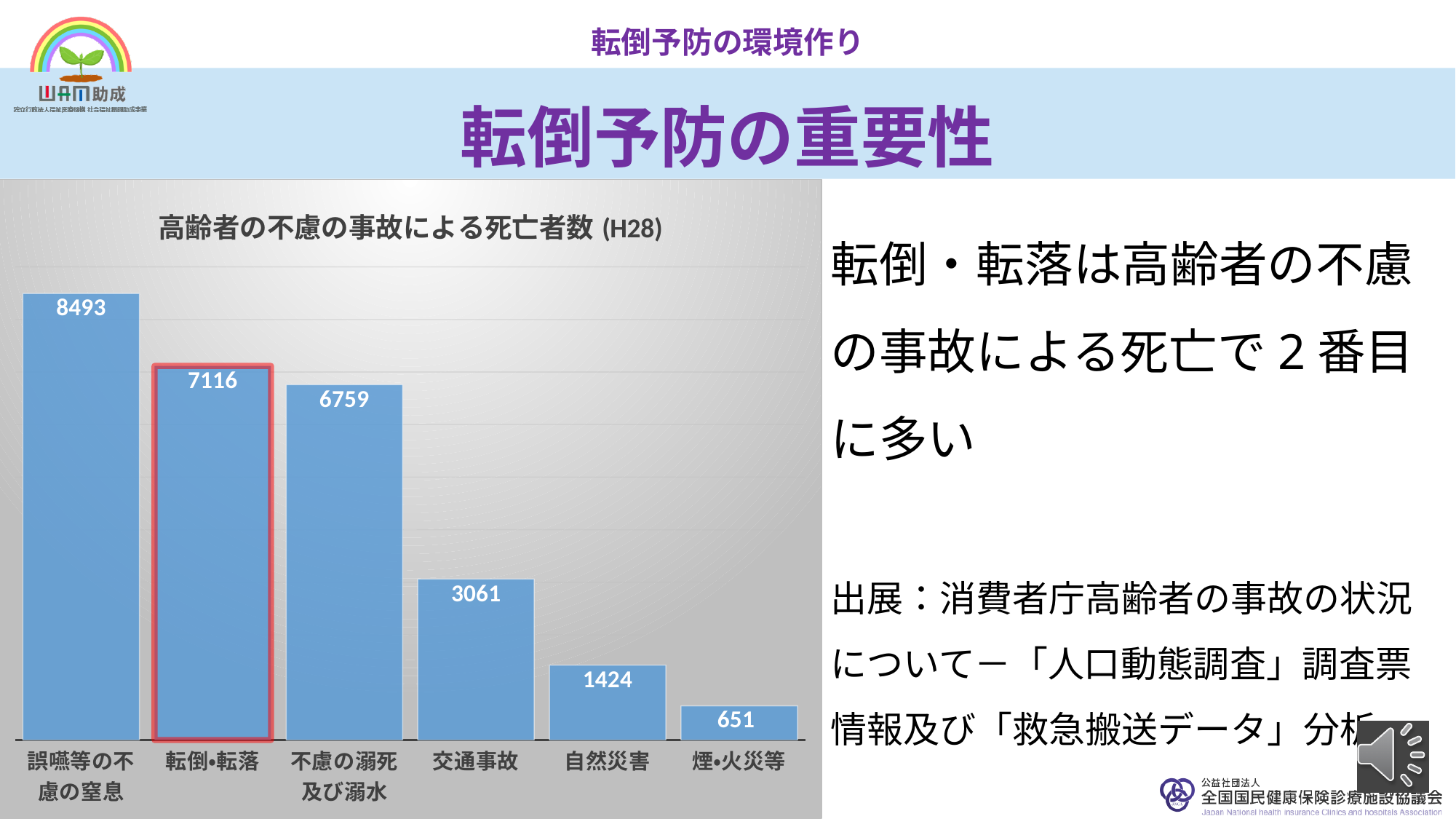
How many categories are shown in the chart? 6 What is the difference between 誤嚥等の不慮の窒息 and 転倒・転落? 1377 Which is larger, 自然災害 or 交通事故? 交通事故 What is the title of the chart? 高齢者の不慮の事故による死亡者数 (H28) Which category has the lowest value? 煙・火災等 What is the value for 転倒・転落? 7116 What is the value for 煙・火災等? 651 What kind of chart is shown? Bar chart What is the difference between 転倒・転落 and 不慮の溺死及び溺水? 357 Do the values rise or fall from left to right across the categories? Fall Which category has the highest value? 誤嚥等の不慮の窒息 What is the value for 交通事故? 3061